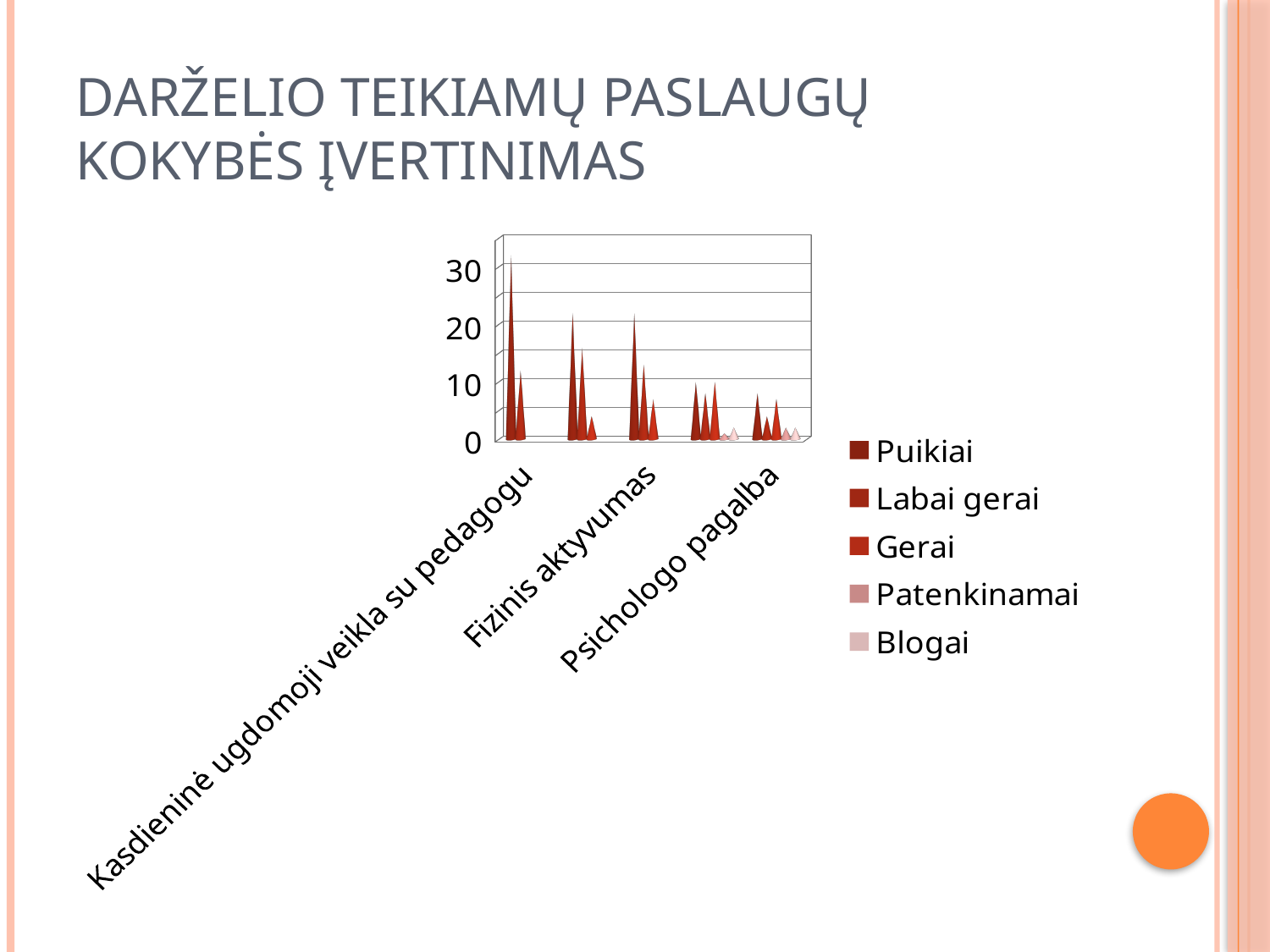
Which is larger for Kasdieninė ugdomoji veikla su pedagogu: the Puikiai value or the Labai gerai value? Puikiai Which category has the highest value for the Puikiai series? Kasdieninė ugdomoji veikla su pedagogu What kind of chart is shown on the slide? bar chart Which category has the larger Puikiai value: Kasdieninė ugdomoji veikla su pedagogu or Psichologo pagalba? Kasdieninė ugdomoji veikla su pedagogu Do the Puikiai values rise or fall from Kasdieninė ugdomoji veikla su pedagogu to Psichologo pagalba along the x axis? fall Is the Puikiai value for Psichologo pagalba greater or less than 10? less How many series does the legend list? 5 Is the Puikiai value for Kasdieninė ugdomoji veikla su pedagogu greater or less than 20? greater What is the first entry listed in the chart legend? Puikiai Is the Labai gerai value for Kasdieninė ugdomoji veikla su pedagogu greater or less than 20? less